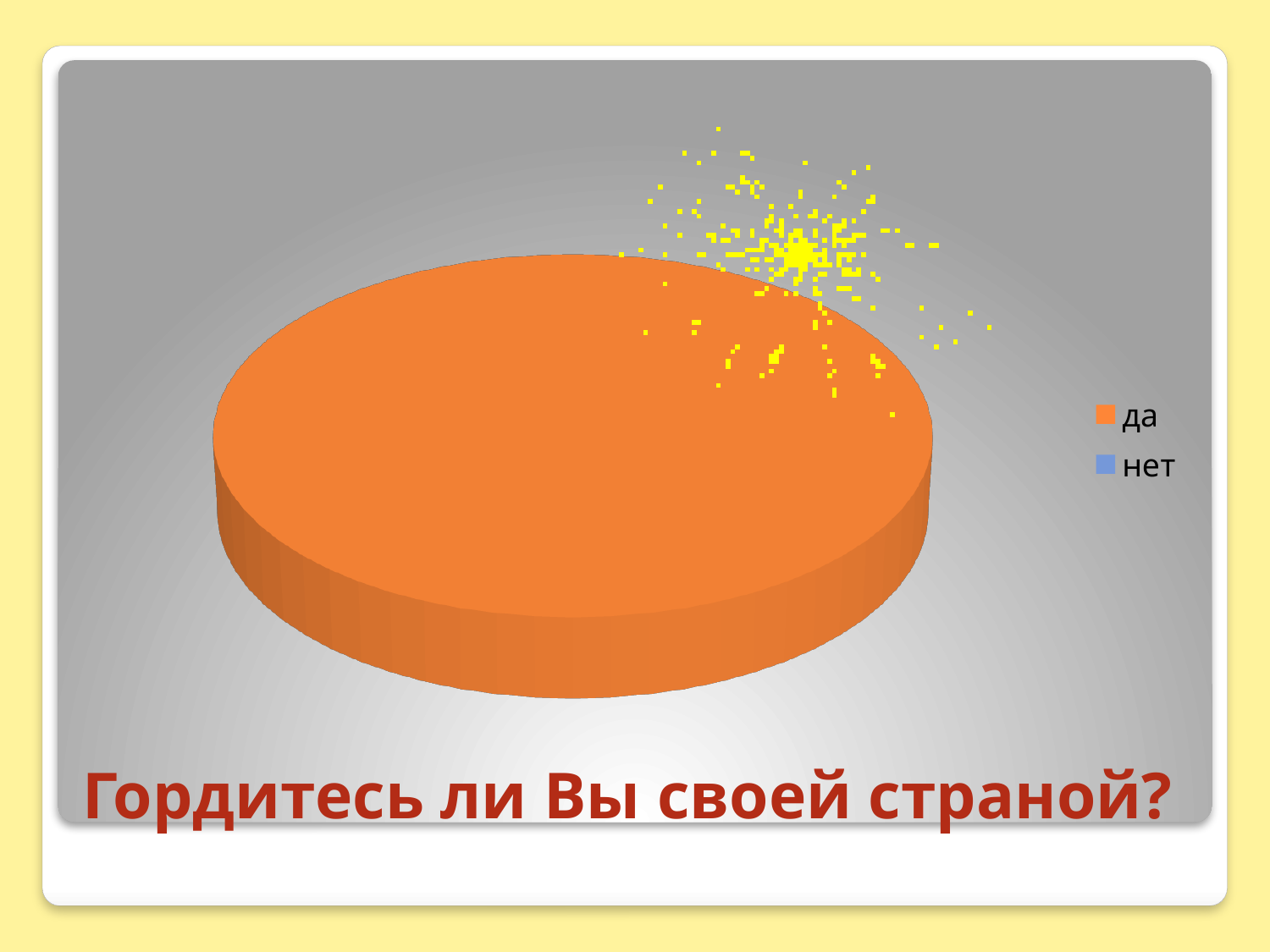
How many entries does the legend of the pie chart list? 2 Which category has the smallest share of the pie chart? нет Which category takes up the largest share of the pie chart? да Which is larger in the pie chart, the share for "да" or the share for "нет"? да What question is written as the title below the pie chart? Гордитесь ли Вы своей страной? What colour represents "да" in the pie chart legend? orange What kind of chart is shown on the slide? pie chart